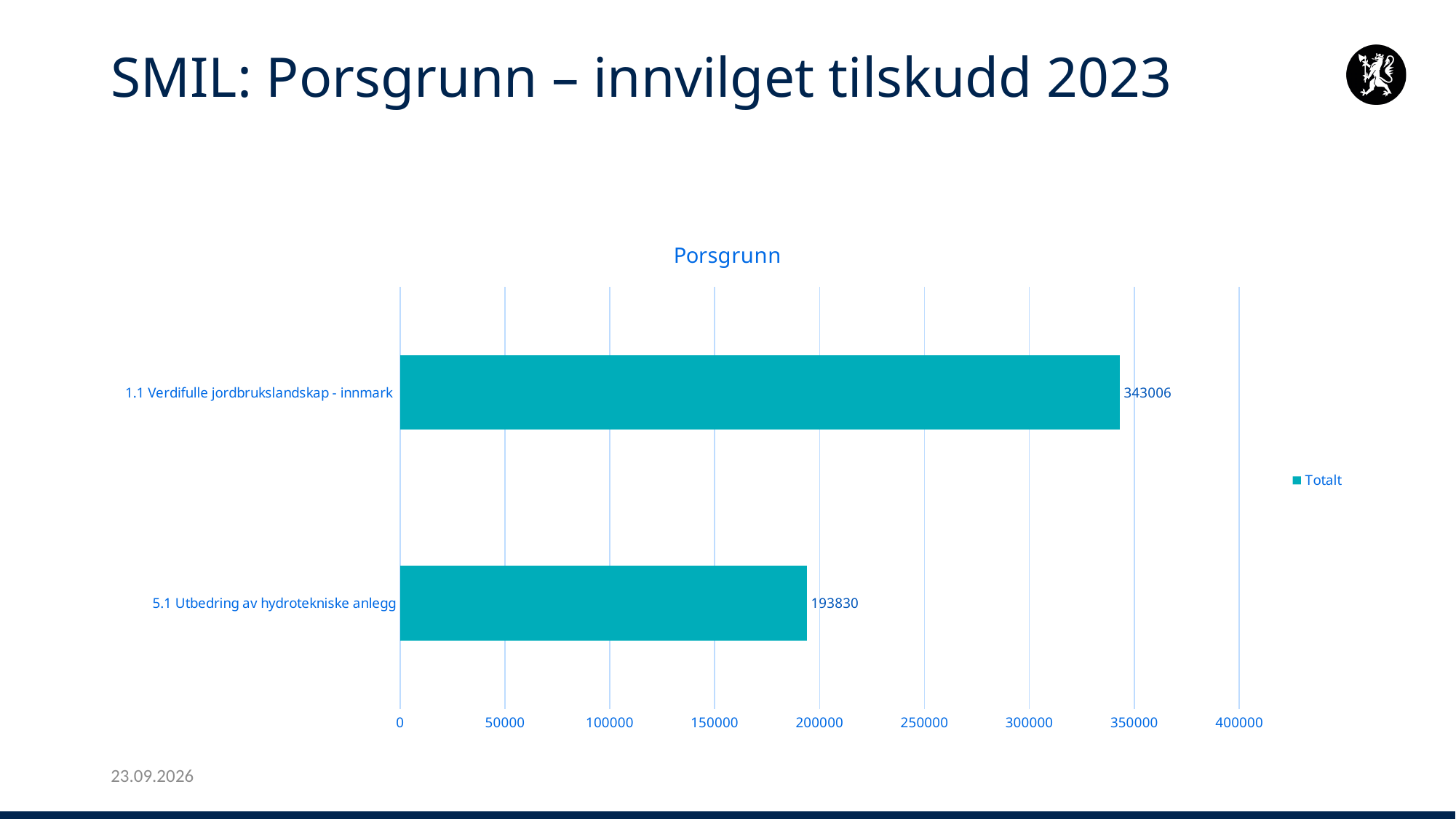
Is the value for 5.1 Utbedring av hydrotekniske anlegg greater or less than 200000? less What is the value for 1.1 Verdifulle jordbrukslandskap - innmark? 343006 What is the difference between the values for 1.1 Verdifulle jordbrukslandskap - innmark and 5.1 Utbedring av hydrotekniske anlegg? 149176 How many series does the legend list? 1 Which category has the lowest value? 5.1 Utbedring av hydrotekniske anlegg What is the title of the chart? Porsgrunn What kind of chart is shown on the slide? bar chart How many categories are shown in the chart? 2 Which category has the highest value? 1.1 Verdifulle jordbrukslandskap - innmark What is the value for 5.1 Utbedring av hydrotekniske anlegg? 193830 Which is larger: the value for 1.1 Verdifulle jordbrukslandskap - innmark or for 5.1 Utbedring av hydrotekniske anlegg? 1.1 Verdifulle jordbrukslandskap - innmark Is the value for 1.1 Verdifulle jordbrukslandskap - innmark greater or less than 300000? greater